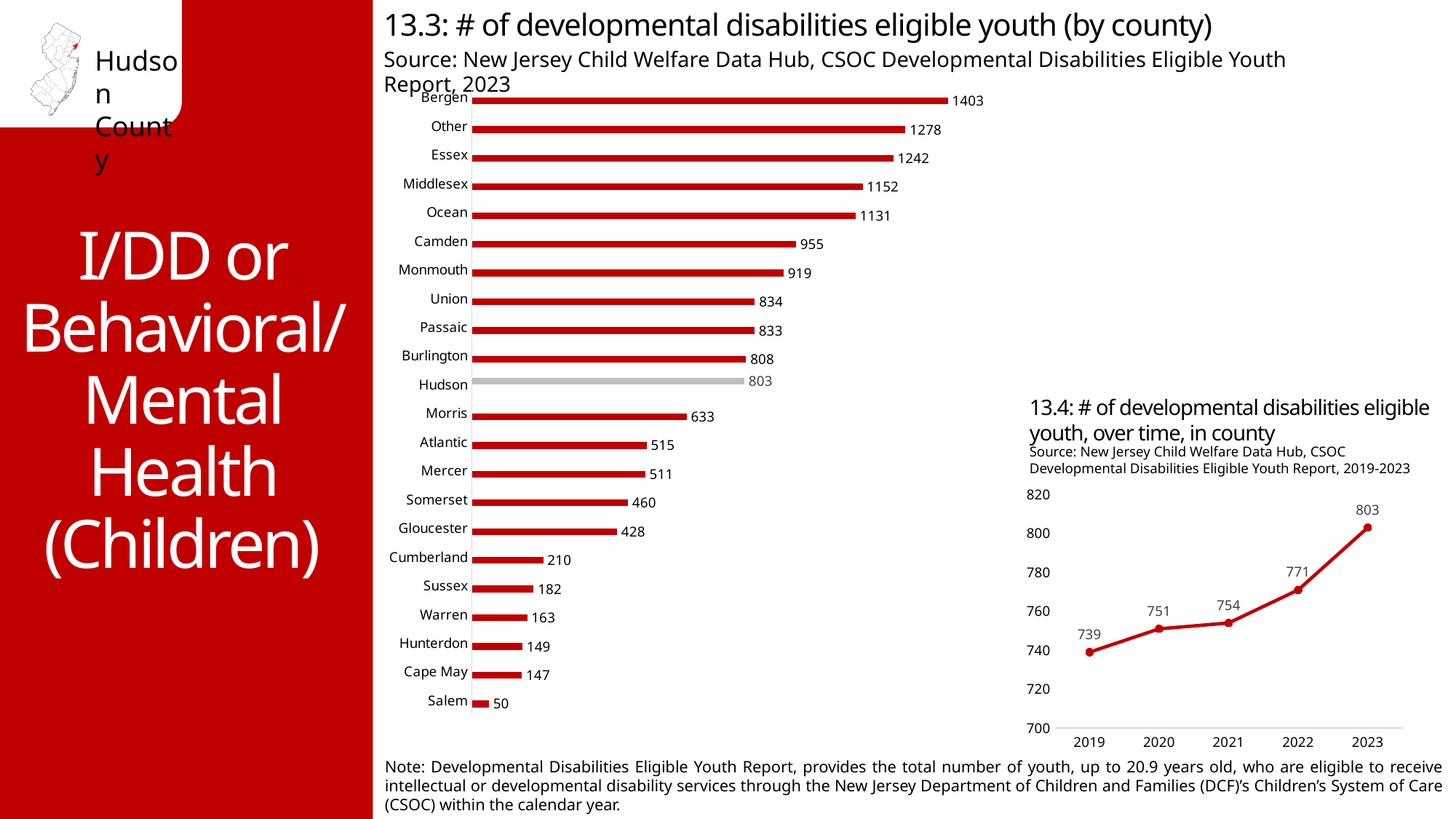
In chart 13.3 (by county), which is larger, the value for Camden or the value for Morris? Camden In chart 13.4 (over time, in county), what is the value for 2021? 754 In chart 13.3 (by county), how many categories are shown? 22 What kind of chart is chart 13.4 (over time, in county)? Line chart What kind of chart is chart 13.3 (by county)? Bar chart In chart 13.3 (by county), what is the value for Cumberland? 210 In chart 13.3 (by county), what is the difference between Bergen and Hudson? 600 In chart 13.3 (by county), which county has the lowest number of eligible youth? Salem In chart 13.3 (# of developmental disabilities eligible youth by county), what is the value for Hudson? 803 In chart 13.4 (over time, in county), do the values rise or fall from 2019 to 2023? Rise In chart 13.3 (by county), which county has the highest number of eligible youth? Bergen In chart 13.4 (over time, in county), what is the difference between the 2023 and 2019 values? 64